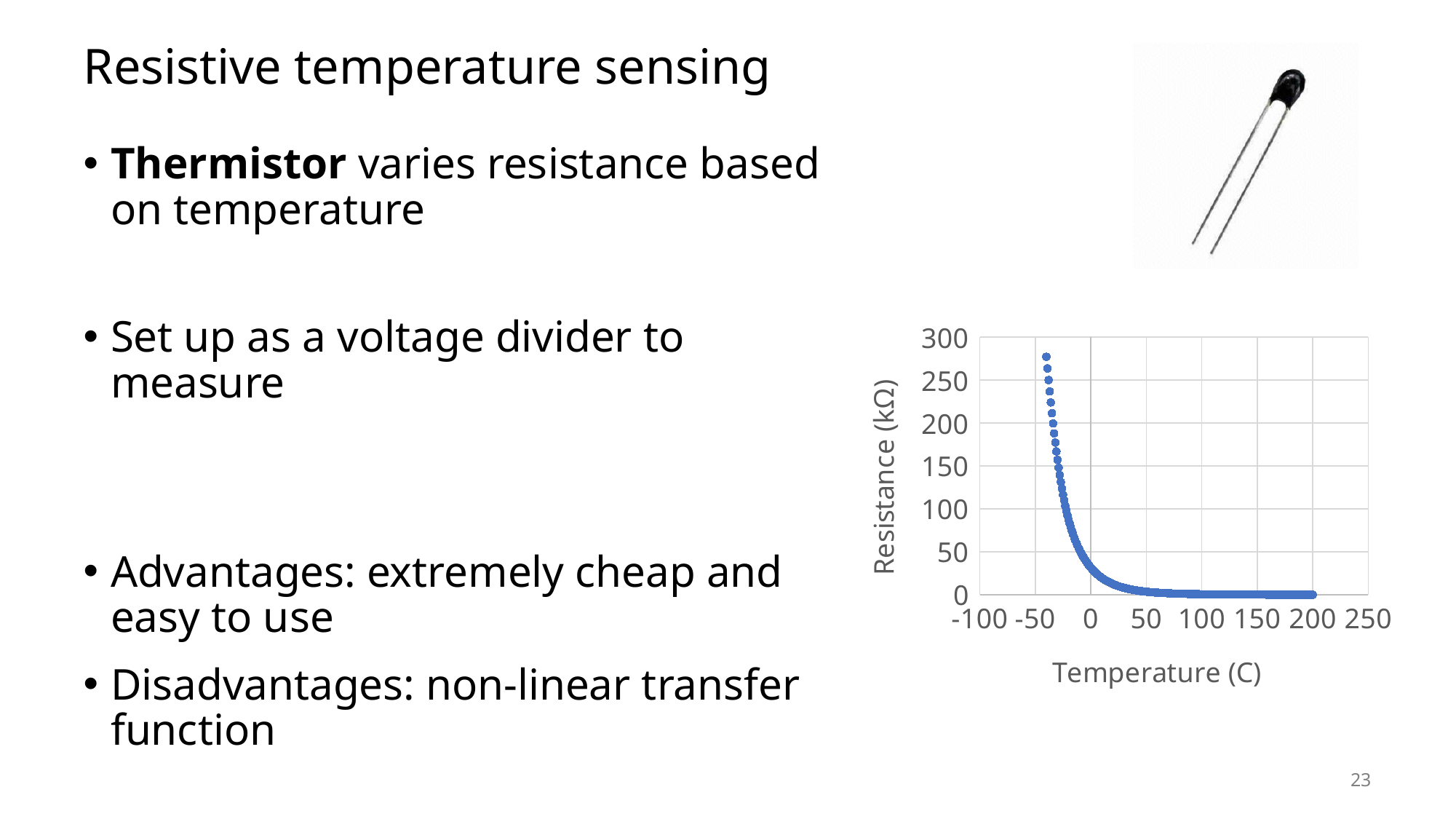
What is the label of the y axis of the chart? Resistance (kΩ) What kind of chart is shown on the slide? scatter chart Is the resistance at a temperature of 200 C greater or less than 50? less Is the resistance at a temperature of 0 C greater or less than 100? less Which has the higher resistance: the point at 0 C or the point at 150 C? 0 C What is the label of the x axis of the chart? Temperature (C) Is the highest plotted resistance value greater or less than 250? greater What is the highest value shown on the y axis of the chart? 300 Does the resistance rise or fall as temperature increases along the x axis? fall